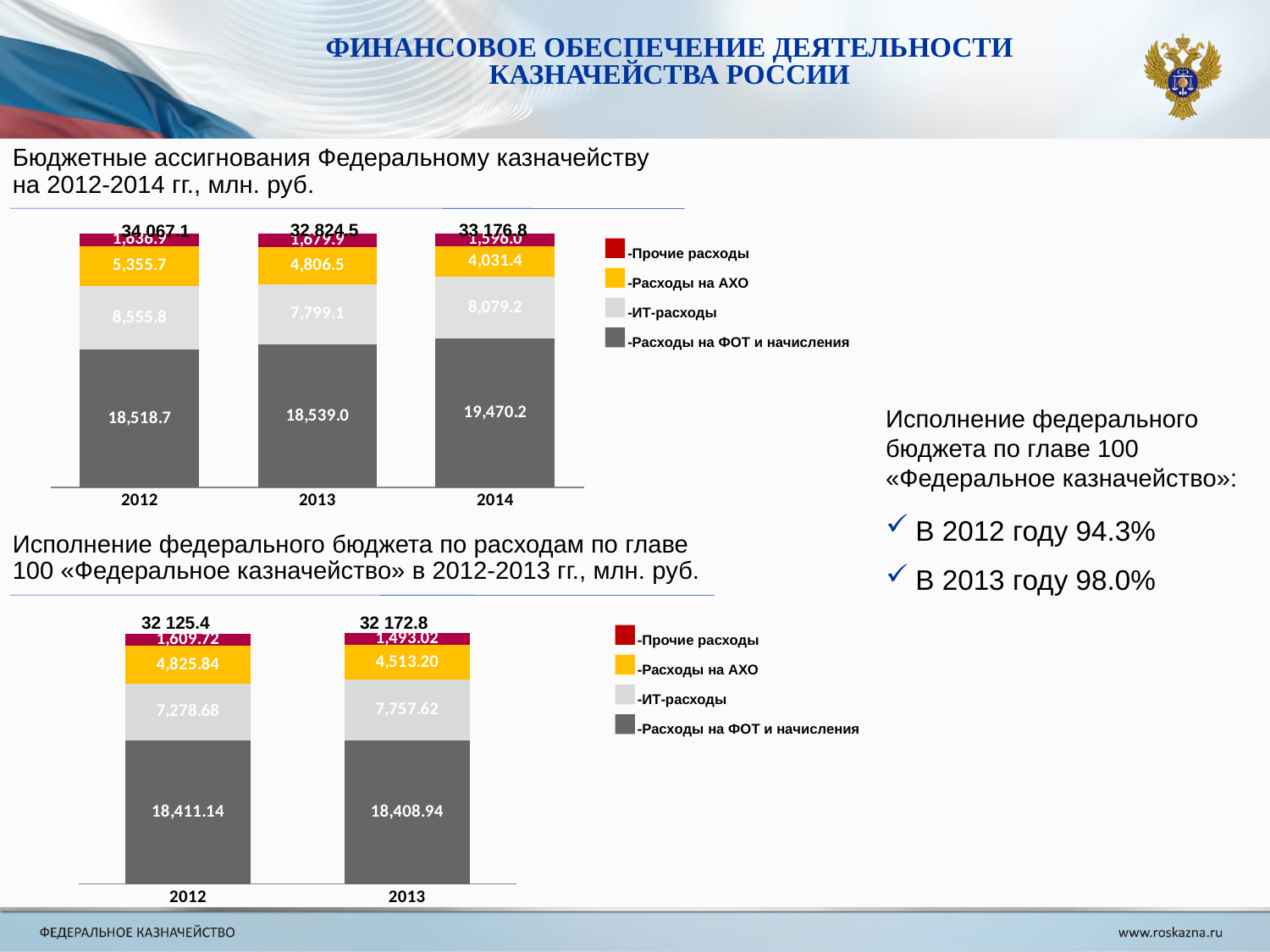
In the bottom chart (Исполнение федерального бюджета), how many years are shown on the x axis? 2 In the top chart (Бюджетные ассигнования), what is the value for ИТ-расходы in 2013? 7,799.1 In the bottom chart (Исполнение федерального бюджета), what is the total of the stacked bar for 2013? 32 172.8 In the top chart (Бюджетные ассигнования), which year has the lowest total? 2013 In the top chart (Бюджетные ассигнования), what is the difference between Расходы на АХО in 2012 and in 2014? 1,324.3 In the top chart (Бюджетные ассигнования), how many series does the legend list? 4 In the top chart (Бюджетные ассигнования), do the values for Расходы на АХО rise or fall from 2012 to 2014? fall In the top chart (Бюджетные ассигнования Федеральному казначейству на 2012-2014 гг.), what is the value for Расходы на ФОТ и начисления in 2014? 19,470.2 What type of chart is the bottom chart (Исполнение федерального бюджета)? stacked bar chart In the bottom chart (Исполнение федерального бюджета), which is larger: Расходы на АХО in 2012 or in 2013? 2012 In the bottom chart (Исполнение федерального бюджета по расходам по главе 100), what is the value for ИТ-расходы in 2013? 7,757.62 In the top chart (Бюджетные ассигнования), what is the total of the stacked bar for 2012? 34,067.1